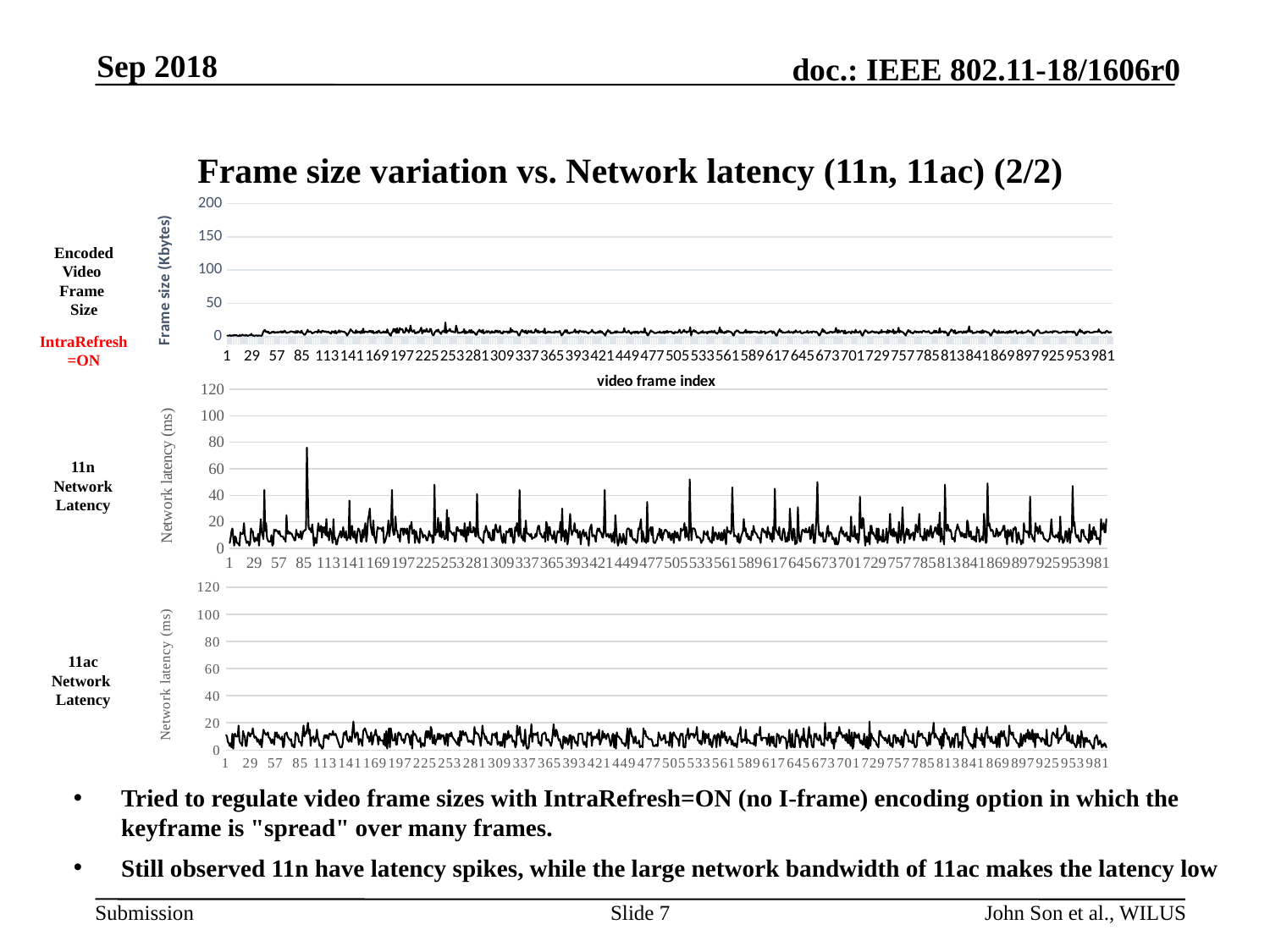
What is the y-axis label of the top Encoded Video Frame Size chart? Frame size (Kbytes) What is the maximum value shown on the y-axis of the 11ac Network Latency chart? 120 In the 11n Network Latency chart, is the highest latency spike greater or less than 80? less Which chart shows a higher peak network latency, the 11n Network Latency chart or the 11ac Network Latency chart? 11n Network Latency In the 11n Network Latency chart, is the highest latency spike greater or less than 60? greater What is the maximum value shown on the y-axis of the top Encoded Video Frame Size chart? 200 How many data series are plotted in the 11n Network Latency chart? 1 In the 11ac Network Latency chart, are all plotted latency values greater or less than 40? less What kind of chart is the 11n Network Latency chart? line chart What is the x-axis label of the top Encoded Video Frame Size chart? video frame index What kind of chart is the top chart showing Encoded Video Frame Size? line chart